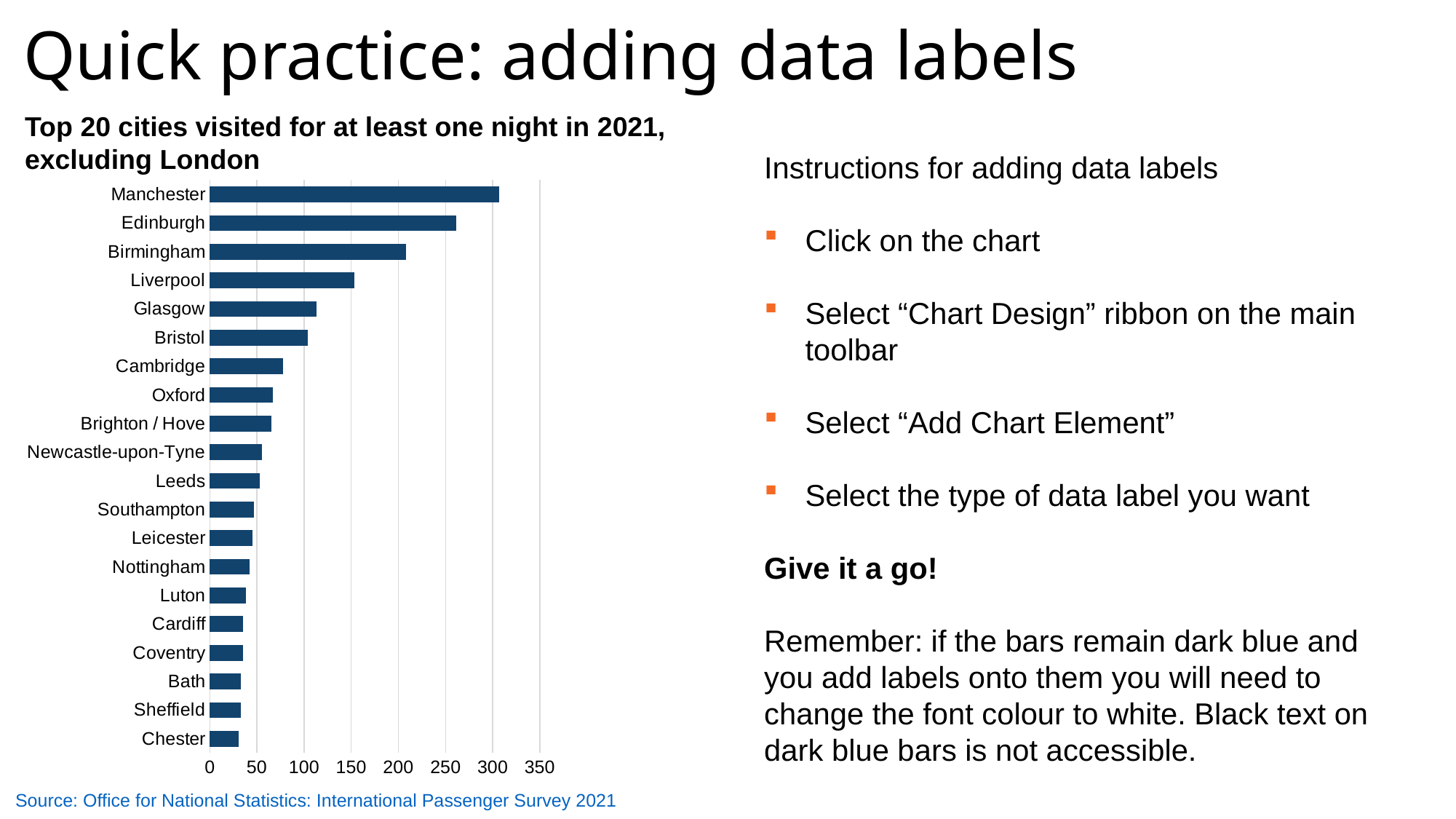
Which city has the lowest value in the chart? Chester Is the value for Glasgow greater or less than 150? less Which has a larger value, Birmingham or Liverpool? Birmingham What is the title of the chart? Top 20 cities visited for at least one night in 2021, excluding London What kind of chart is shown on the slide? bar chart How many cities are shown in the chart? 20 Is the value for Edinburgh greater or less than 250? greater Which city has the highest value in the chart? Manchester Which has a larger value, Chester or Bristol? Bristol Is the value for Manchester greater or less than 300? greater